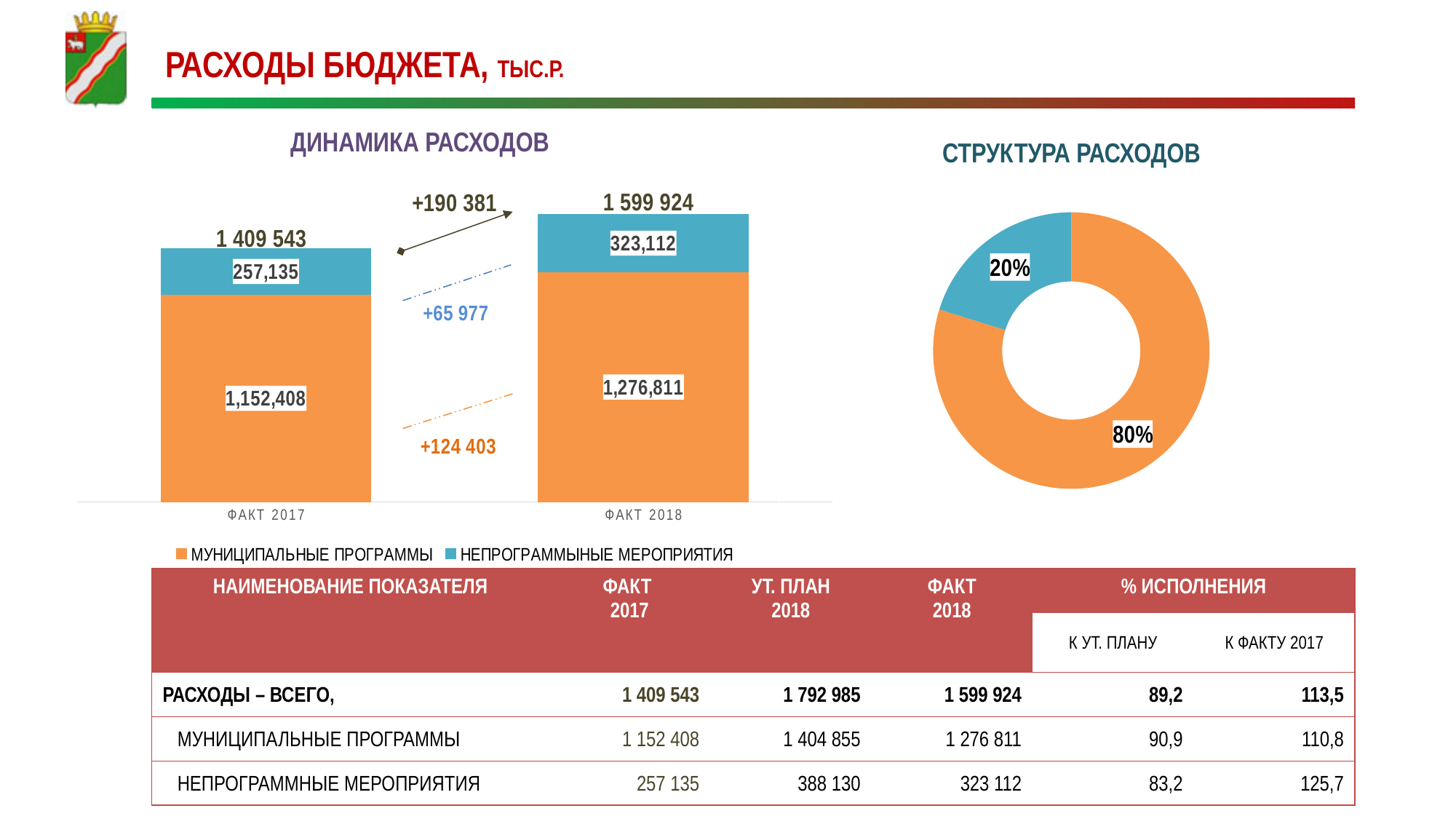
In the ДИНАМИКА РАСХОДОВ chart, what is the total of the ФАКТ 2018 bar? 1 599 924 How many series does the legend of the ДИНАМИКА РАСХОДОВ chart list? 2 In the ДИНАМИКА РАСХОДОВ chart, by how much did НЕПРОГРАММНЫЕ МЕРОПРИЯТИЯ increase from ФАКТ 2017 to ФАКТ 2018? 65 977 In the СТРУКТУРА РАСХОДОВ chart, what share does the larger (orange) slice have? 80% In the ДИНАМИКА РАСХОДОВ chart, by how much did МУНИЦИПАЛЬНЫЕ ПРОГРАММЫ increase from ФАКТ 2017 to ФАКТ 2018? 124 403 In the ДИНАМИКА РАСХОДОВ chart, what is the value of НЕПРОГРАММНЫЕ МЕРОПРИЯТИЯ for ФАКТ 2017? 257,135 In the ДИНАМИКА РАСХОДОВ chart, which bar has the larger value for НЕПРОГРАММНЫЕ МЕРОПРИЯТИЯ, ФАКТ 2017 or ФАКТ 2018? ФАКТ 2018 How many categories are shown on the x axis of the ДИНАМИКА РАСХОДОВ chart? 2 In the ДИНАМИКА РАСХОДОВ chart, what is the value of МУНИЦИПАЛЬНЫЕ ПРОГРАММЫ for ФАКТ 2018? 1,276,811 In the ДИНАМИКА РАСХОДОВ chart, what is the total of the ФАКТ 2017 bar? 1 409 543 What kind of chart is the СТРУКТУРА РАСХОДОВ chart? Doughnut chart What kind of chart is the ДИНАМИКА РАСХОДОВ chart? Stacked bar chart